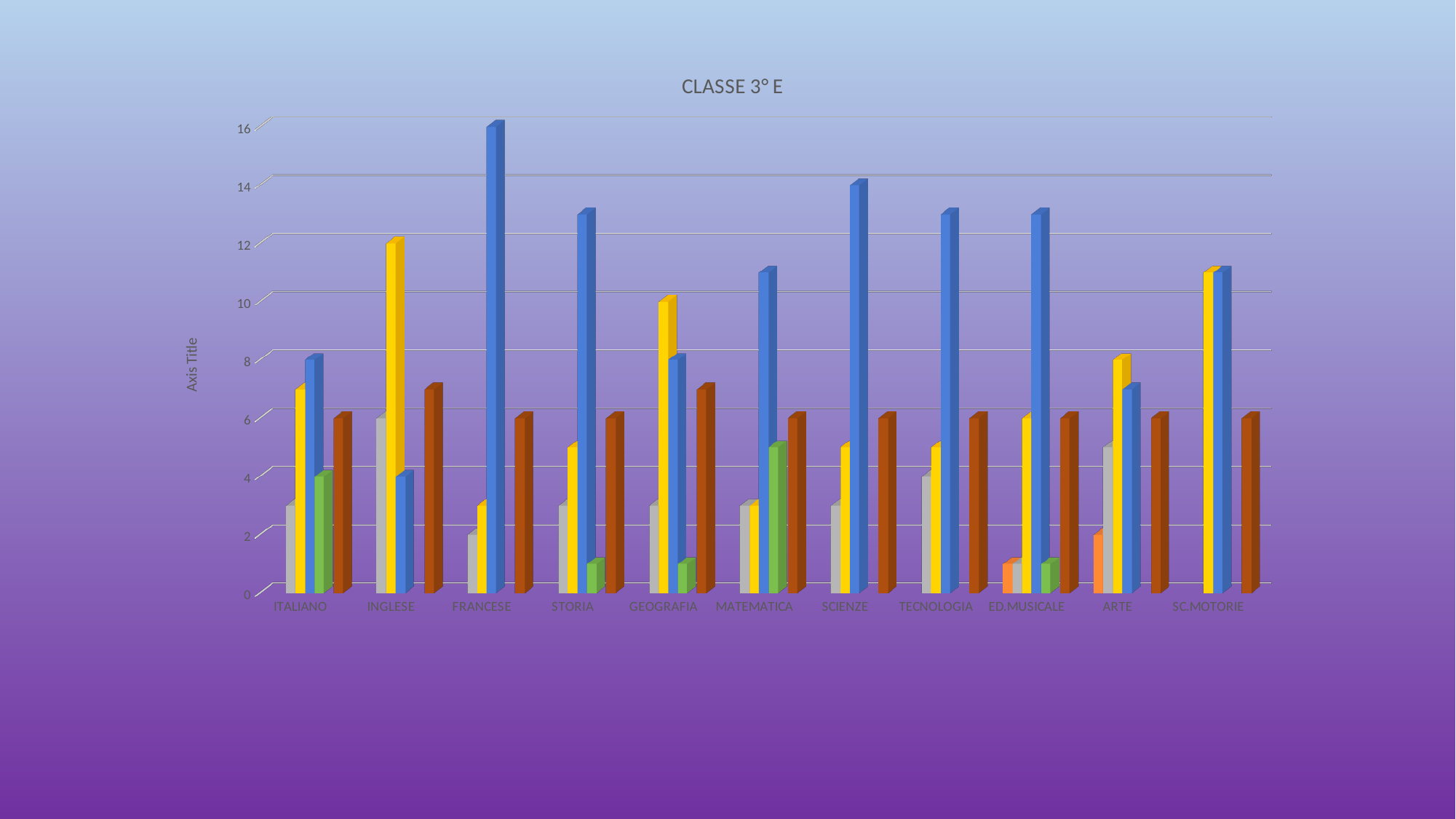
How many categories are shown along the x axis of the chart? 11 Is the tallest bar for FRANCESE greater or less than 14? greater What kind of chart is shown on the slide? bar chart What is the title of the chart? CLASSE 3° E Which is taller: the tallest bar for FRANCESE or the tallest bar for SCIENZE? FRANCESE Is the tallest bar for ARTE greater or less than 10? less What text is shown as the vertical axis title? Axis Title Is the tallest bar for ITALIANO greater or less than 10? less Which category contains the tallest bar in the whole chart? FRANCESE